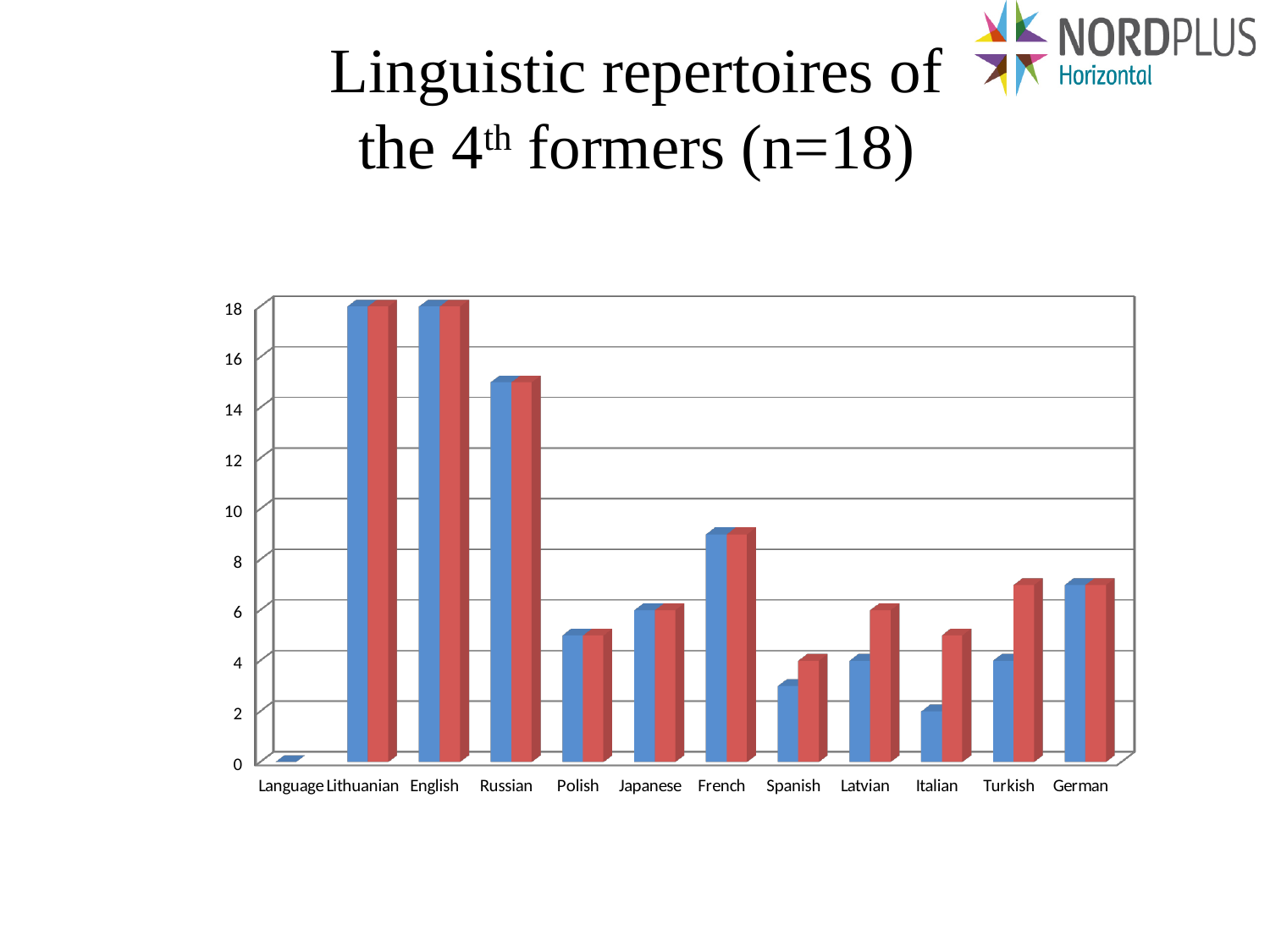
Is the value for Polish greater or less than 8? less Is the value for Russian greater or less than 14? greater Is the value for German greater or less than 6? greater What kind of chart is shown on the slide? bar chart What value do the bars for Lithuanian reach? 18 For Turkish, which bar is taller, the blue bar or the red bar? the red bar Which has the larger value, Russian or French? Russian How many categories are labelled along the x axis of the chart? 12 What is the title of the slide containing the chart? Linguistic repertoires of the 4th formers (n=18) Which languages have the tallest bars in the chart? Lithuanian and English